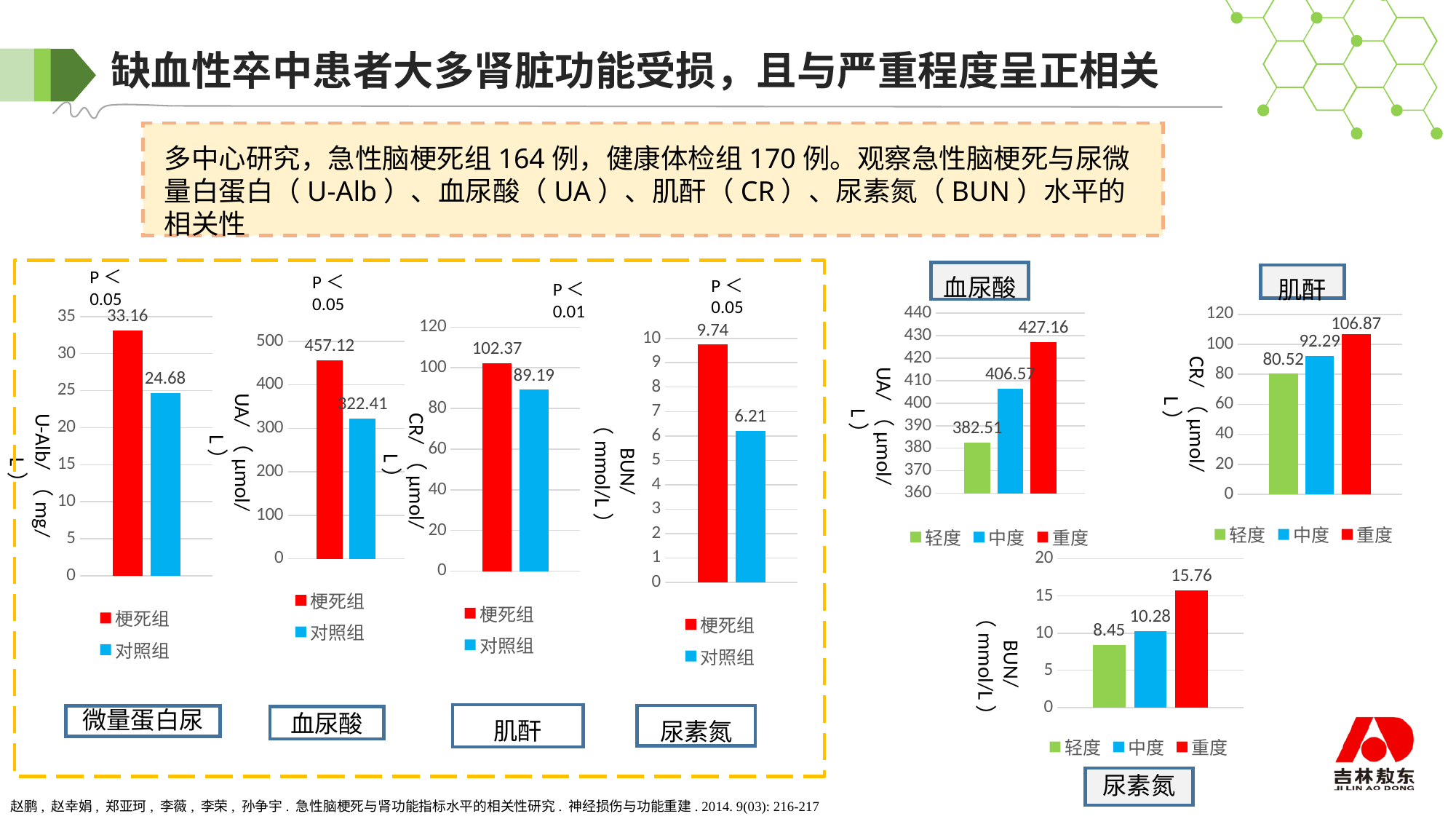
In the 微量蛋白尿 chart in the left dashed box, what is the difference between 梗死组 and 对照组? 8.48 In the 血尿酸 chart on the right side of the slide, which severity group has the lowest value? 轻度 What kind of chart is the 尿素氮 chart on the right side of the slide? bar chart In the 肌酐 chart on the right side of the slide, what is the value for 中度? 92.29 How many series does the legend of the 肌酐 chart on the right side of the slide list? 3 In the 微量蛋白尿 chart in the left dashed box, what is the value for 梗死组? 33.16 In the 血尿酸 chart on the right side of the slide, what is the value for 重度? 427.16 In the 尿素氮 chart on the right side of the slide, do the values rise or fall from 轻度 to 重度? rise In the 尿素氮 chart in the left dashed box, what is the difference between 梗死组 and 对照组? 3.53 In the 肌酐 chart in the left dashed box, which group has the higher value, 梗死组 or 对照组? 梗死组 In the 血尿酸 chart in the left dashed box, what is the value for 对照组? 322.41 In the 尿素氮 chart in the left dashed box, what is the value for 梗死组? 9.74